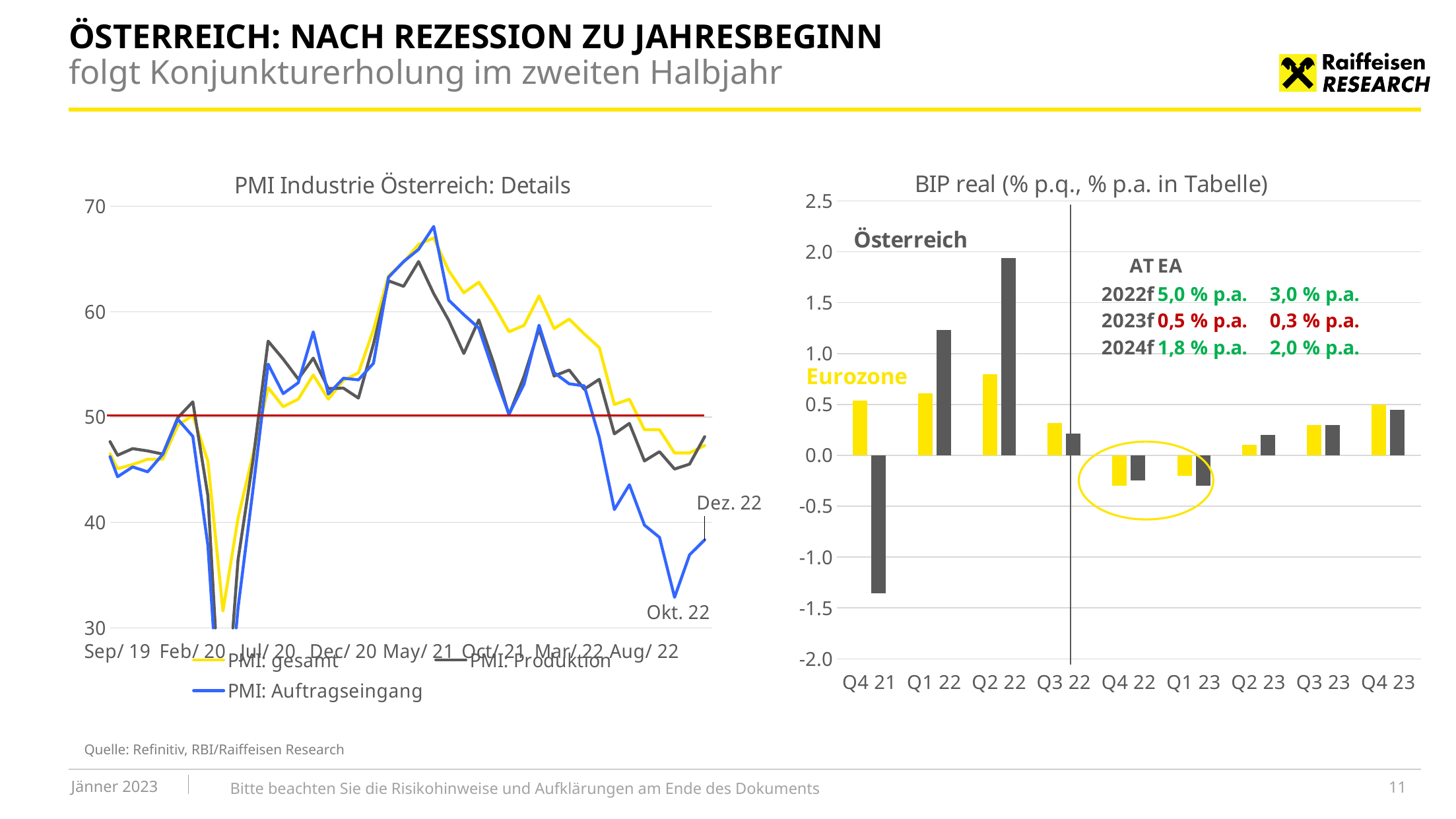
In the left chart 'PMI Industrie Österreich: Details', at what level is the red horizontal reference line drawn? 50 What kind of chart is the left chart titled 'PMI Industrie Österreich: Details'? line chart In the right chart 'BIP real', in which quarter is the Österreich bar highest? Q2 22 In the left chart 'PMI Industrie Österreich: Details', is the value of PMI: Auftragseingang at Okt. 22 greater or less than 40? less In the right chart 'BIP real', in which quarter is the Österreich bar lowest? Q4 21 In the right chart 'BIP real', is the Österreich value for Q4 21 greater or less than -1.0? less How many quarters are shown on the x axis of the right chart 'BIP real (% p.q., % p.a. in Tabelle)'? 9 In the left chart 'PMI Industrie Österreich: Details', do the PMI: gesamt values rise or fall between Mar/22 and Aug/22? fall How many series does the legend of the left chart 'PMI Industrie Österreich: Details' list? 3 What kind of chart is the right chart titled 'BIP real (% p.q., % p.a. in Tabelle)'? bar chart In the right chart 'BIP real', what is the 2023f forecast for AT shown in the table? 0,5 % p.a. In the right chart 'BIP real', which is larger in Q2 22, the Österreich bar or the Eurozone bar? Österreich